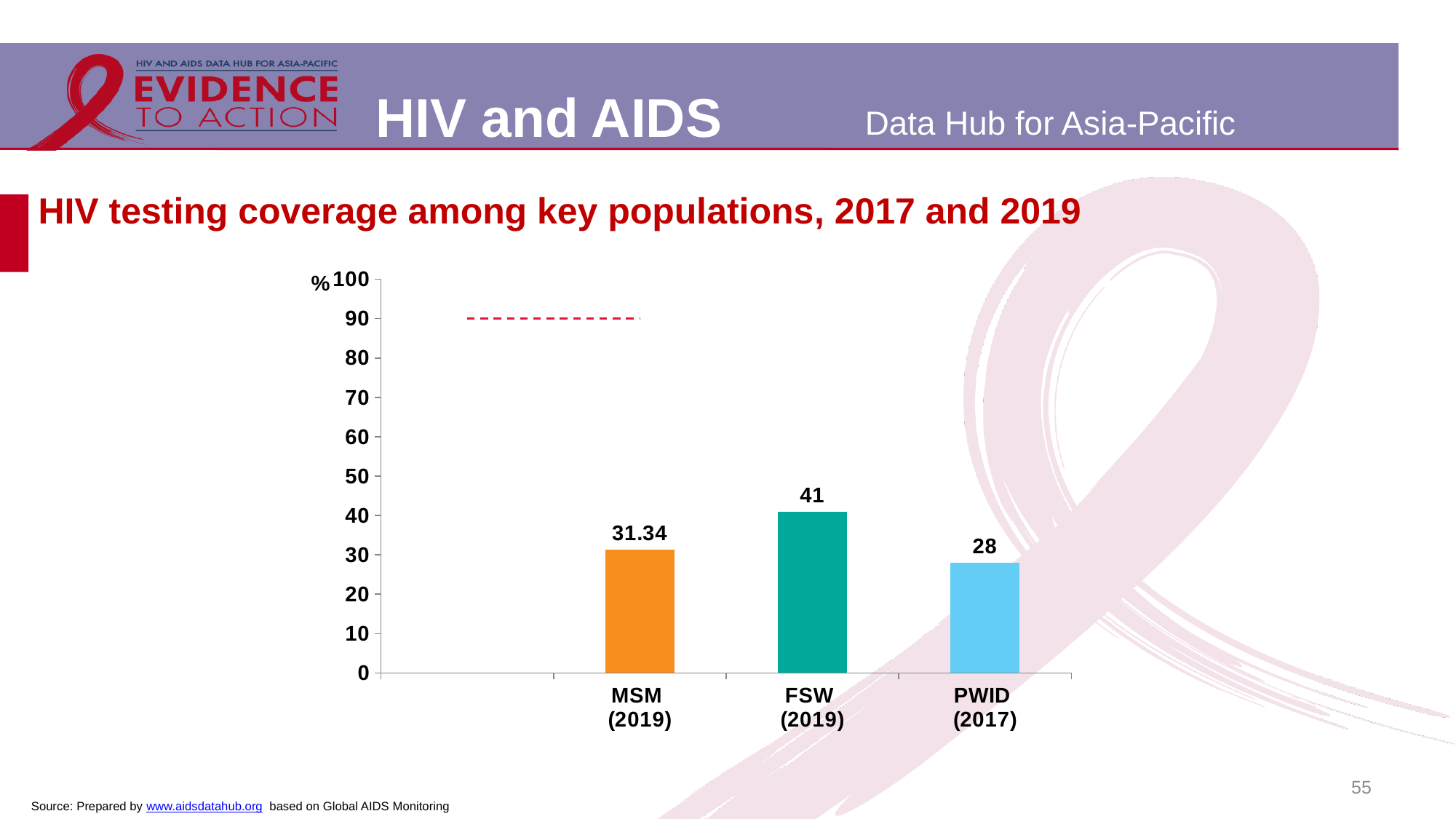
Is the value for FSW (2019) greater or less than 50? less What is the difference between the HIV testing coverage for FSW (2019) and PWID (2017)? 13 What is the HIV testing coverage value for PWID (2017)? 28 What is the HIV testing coverage value for FSW (2019)? 41 Which key population has the lowest HIV testing coverage? PWID (2017) What kind of chart is shown on the slide? bar chart What is the title of the chart on the slide? HIV testing coverage among key populations, 2017 and 2019 What is the difference between the HIV testing coverage for FSW (2019) and MSM (2019)? 9.66 Which key population has the highest HIV testing coverage? FSW (2019) How many key population categories are shown in the chart? 3 What is the HIV testing coverage value for MSM (2019)? 31.34 Which is larger, the HIV testing coverage for MSM (2019) or PWID (2017)? MSM (2019)